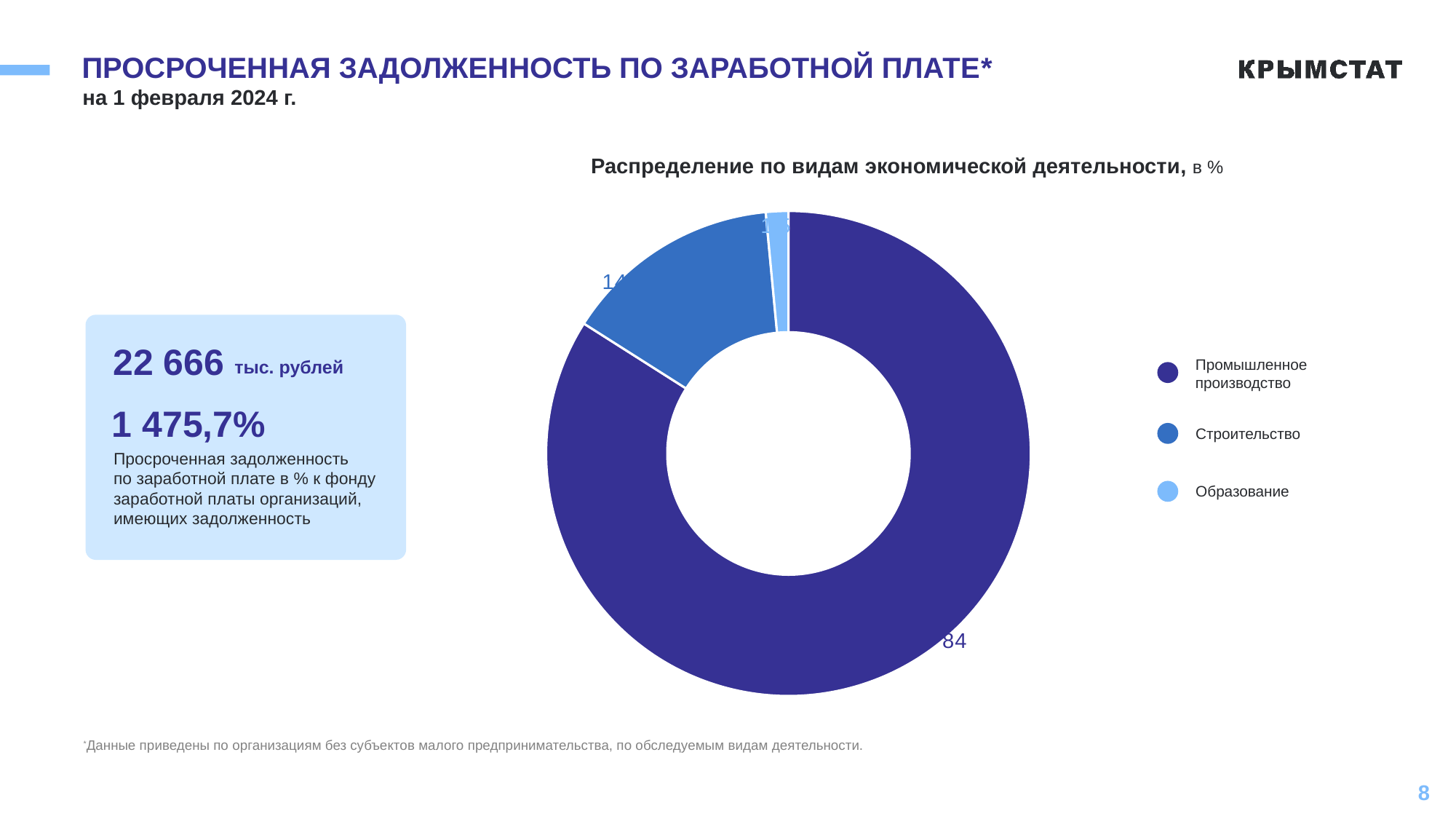
What colour is the Образование slice in the pie chart? light blue How many categories does the pie chart show? 3 Which category has the largest slice in the pie chart? Промышленное производство What is the title of the pie chart? Распределение по видам экономической деятельности, в % How many entries does the legend of the pie chart list? 3 Which category has the smallest slice in the pie chart? Образование What is the value shown for Промышленное производство in the pie chart? 84 Which slice is larger, Строительство or Образование? Строительство What share of the pie does Промышленное производство take, in %? 84 What kind of chart is shown on the slide? doughnut chart